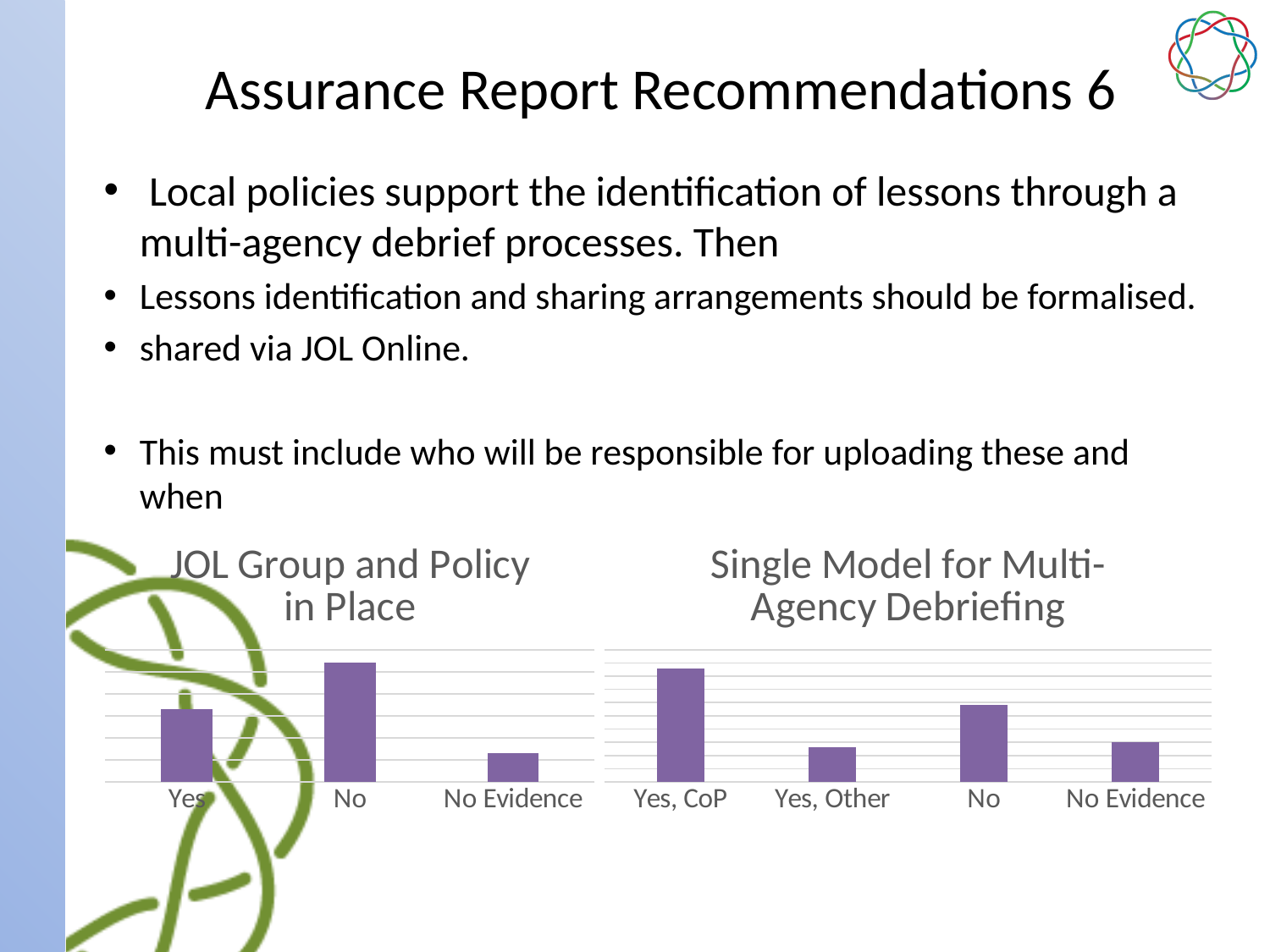
How many categories are shown in the 'JOL Group and Policy in Place' chart? 3 In the 'JOL Group and Policy in Place' chart, which is larger, the value for Yes or the value for No? No What is the title of the chart on the left side of the slide? JOL Group and Policy in Place In the 'JOL Group and Policy in Place' chart, which category has the lowest value? No Evidence In the 'JOL Group and Policy in Place' chart, which category has the highest value? No In the 'Single Model for Multi-Agency Debriefing' chart, which is larger, the value for Yes, CoP or the value for No? Yes, CoP In the 'JOL Group and Policy in Place' chart, which is larger, the value for Yes or the value for No Evidence? Yes In the 'Single Model for Multi-Agency Debriefing' chart, which category has the highest value? Yes, CoP What is the title of the chart on the right side of the slide? Single Model for Multi-Agency Debriefing How many categories are shown in the 'Single Model for Multi-Agency Debriefing' chart? 4 What kind of chart is the 'JOL Group and Policy in Place' chart? Bar chart